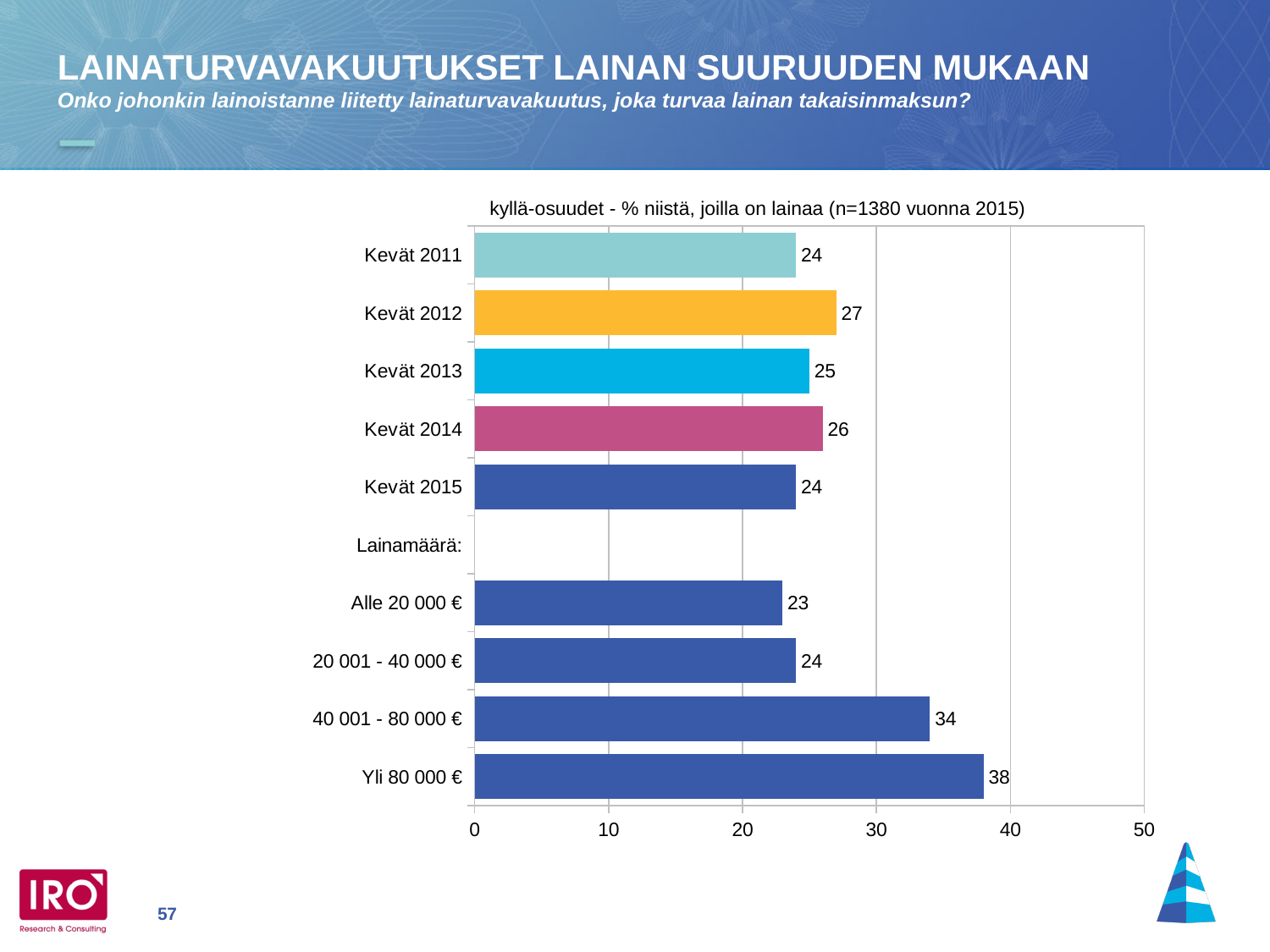
What is the value for Kevät 2012? 27 What is the value for Alle 20 000 €? 23 Which category has the lowest value? Alle 20 000 € Which category has the highest value? Yli 80 000 € What is the value for Yli 80 000 €? 38 Is the value for 40 001 - 80 000 € greater or less than 30? greater How many bars are plotted on the chart? 9 What is the difference between the values for Yli 80 000 € and 40 001 - 80 000 €? 4 Which is larger, the value for Kevät 2012 or the value for Kevät 2014? Kevät 2012 What is the title shown above the chart? kyllä-osuudet - % niistä, joilla on lainaa (n=1380 vuonna 2015) What kind of chart is shown on the slide? bar chart Do the values rise or fall across the loan-amount categories from Alle 20 000 € to Yli 80 000 €? rise